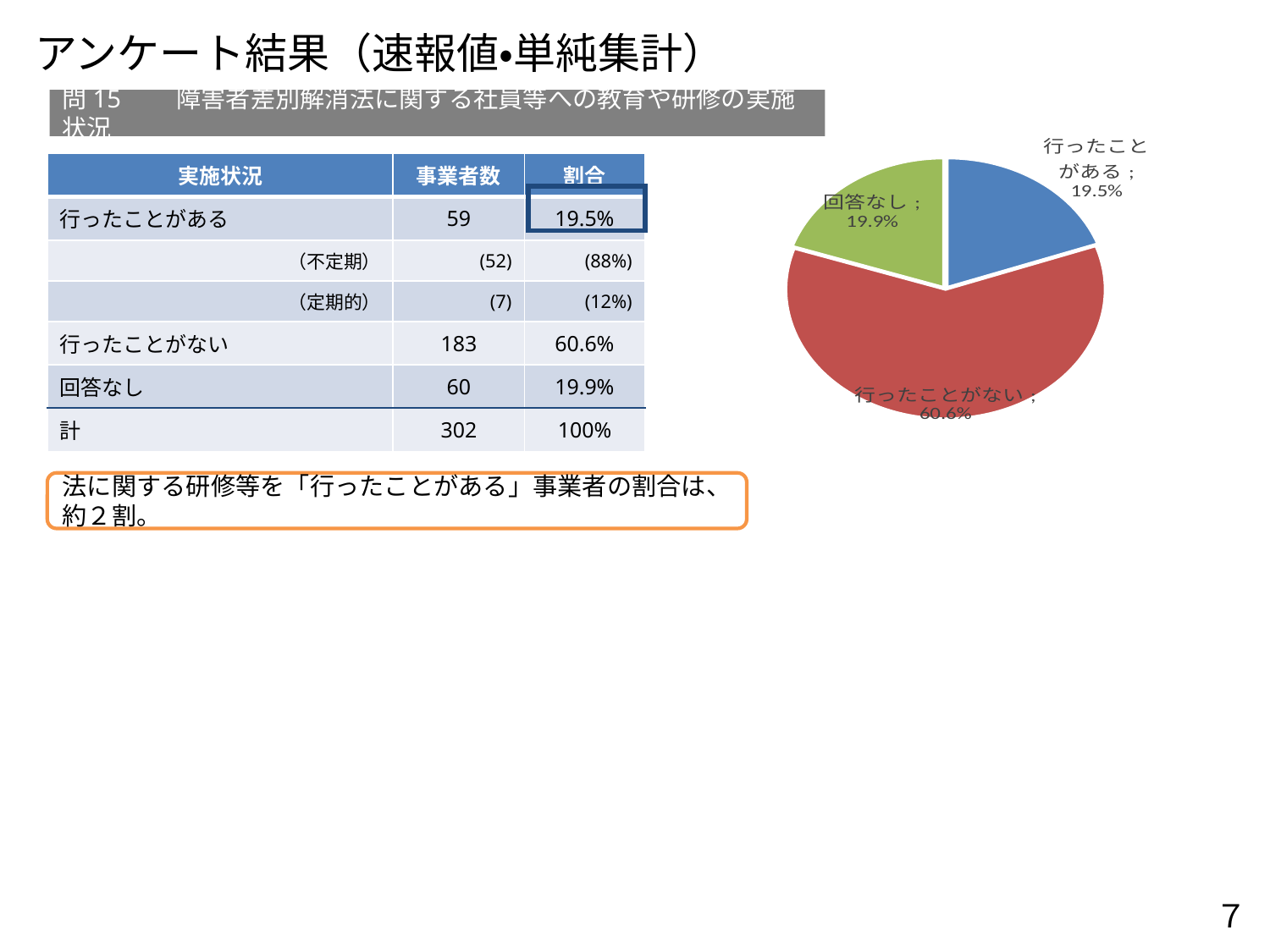
How many slices does the pie chart have? 3 What colour is the 行ったことがない slice in the pie chart? red Which is larger in the pie chart, 行ったことがない or 回答なし? 行ったことがない Which slice of the pie chart is the largest? 行ったことがない What share of the pie does 行ったことがない represent? 60.6% What share of the pie does 行ったことがある represent? 19.5% What kind of chart is shown on the slide? pie chart What is the difference in percentage points between 行ったことがない and 行ったことがある in the pie chart? 41.1 What share of the pie does 回答なし represent? 19.9% Which is larger in the pie chart, 行ったことがある or 行ったことがない? 行ったことがない What colour is the 回答なし slice in the pie chart? green What is the difference in percentage points between 回答なし and 行ったことがある in the pie chart? 0.4